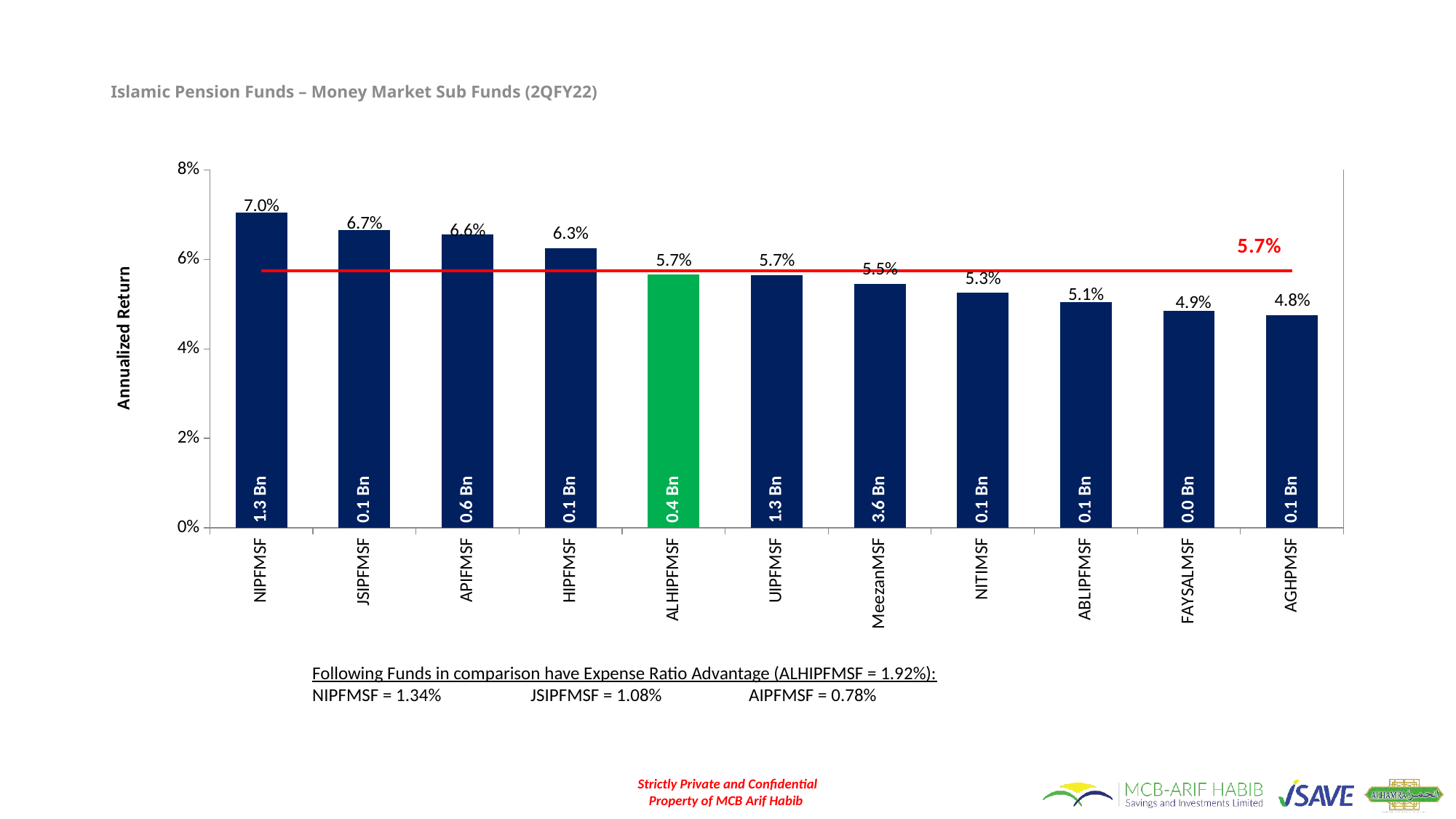
How many funds are shown in the chart? 11 What is the annualized return for AGHPMSF? 4.8% What fund size is printed inside the MeezanMSF bar? 3.6 Bn What is the difference in annualized return between NIPFMSF and AGHPMSF? 2.2% Which has a higher annualized return, HIPFMSF or NITIMSF? HIPFMSF Which fund has the lowest annualized return? AGHPMSF What type of chart is shown on the slide? combination bar and line chart Is the annualized return for FAYSALMSF greater or less than 6%? less Do the annualized returns rise or fall from left to right across the funds? fall What is the annualized return for ALHIPFMSF? 5.7% Which fund has the highest annualized return? NIPFMSF What is the annualized return for NIPFMSF? 7.0%